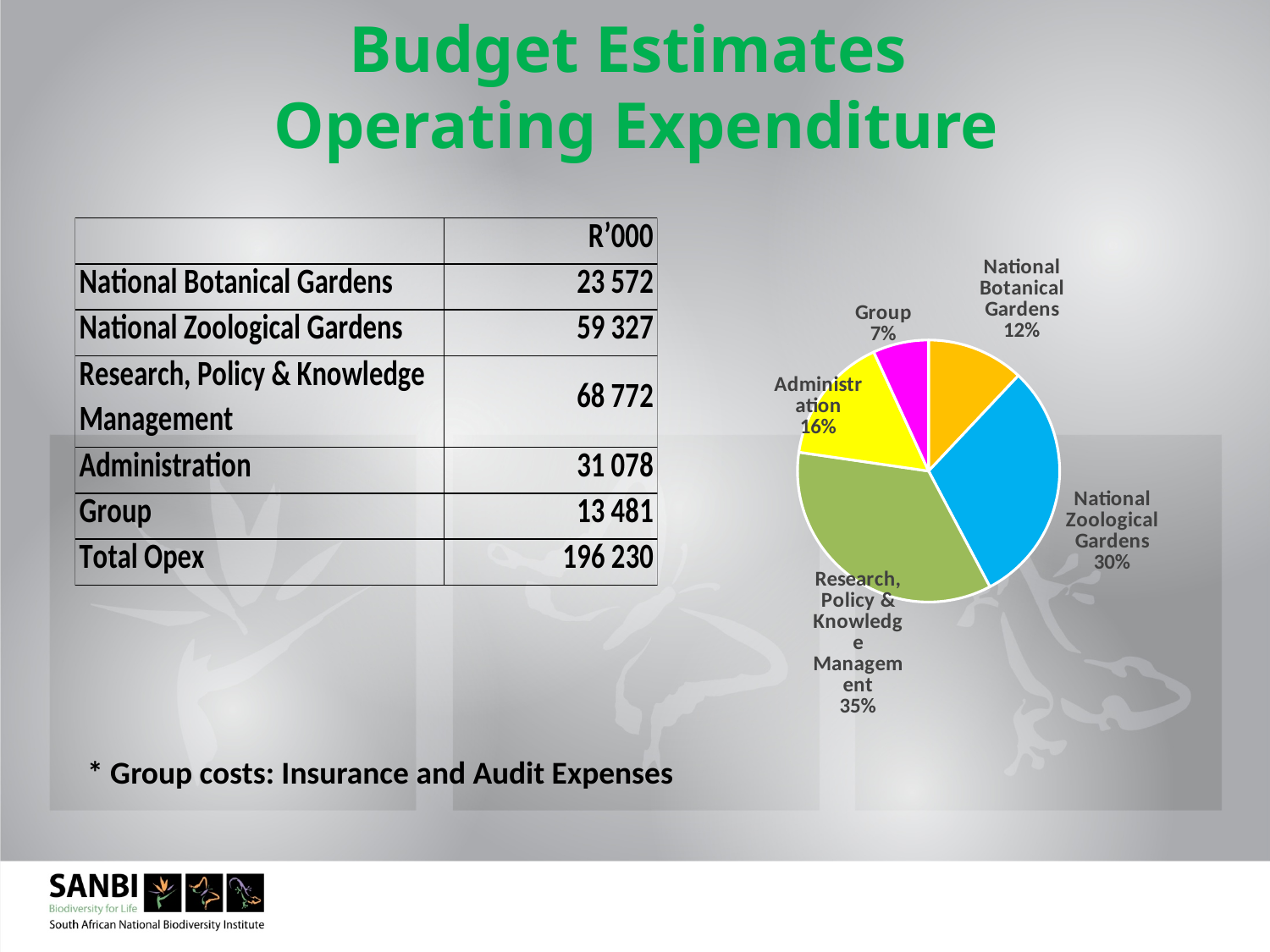
What type of chart is shown on the slide? Pie chart What share of the pie chart does Group represent? 7% What share of the pie chart does National Botanical Gardens represent? 12% What share of the pie chart does National Zoological Gardens represent? 30% What colour is the Group slice in the pie chart? Magenta How many slices does the pie chart have? 5 Which category has the largest slice in the pie chart? Research, Policy & Knowledge Management Which category has the smallest slice in the pie chart? Group What is the difference in percentage points between the Research, Policy & Knowledge Management slice and the Administration slice? 19 Which slice is larger in the pie chart, Administration or Group? Administration What is the difference in percentage points between the National Zoological Gardens slice and the National Botanical Gardens slice? 18